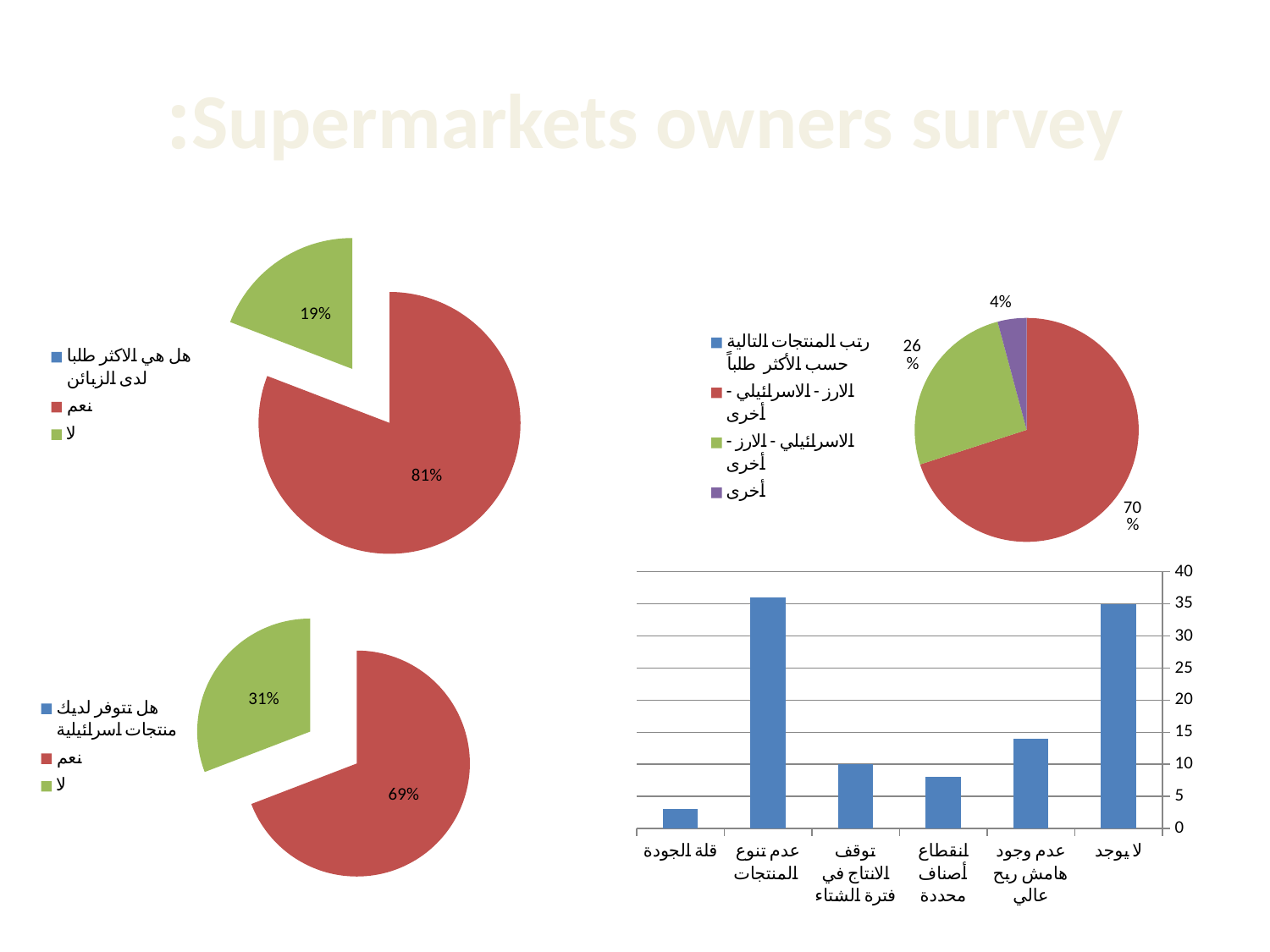
In the top-right pie chart, what percentage is shown for the slice labelled أخرى? 4% In the bottom-right bar chart, which category has the lowest value? قلة الجودة In the bottom-left pie chart, what percentage is shown for the slice labelled نعم? 69% In the top-left pie chart, what percentage is shown for the slice labelled لا? 19% In the top-right pie chart, what percentage is shown for the slice labelled الارز - الاسرائيلي - أخرى? 70% In the bottom-right bar chart, how many categories are shown on the x axis? 6 In the top-right pie chart, which slice is the largest? الارز - الاسرائيلي - أخرى In the bottom-right bar chart, is the value for لا يوجد greater or less than 30? greater What kind of chart is shown at the bottom right of the slide? bar chart In the bottom-left pie chart, what is the difference in percentage points between the نعم slice and the لا slice? 38 In the top-left pie chart, what percentage is shown for the slice labelled نعم? 81% In the bottom-right bar chart, is the value for عدم وجود هامش ربح عالي greater or less than 20? less